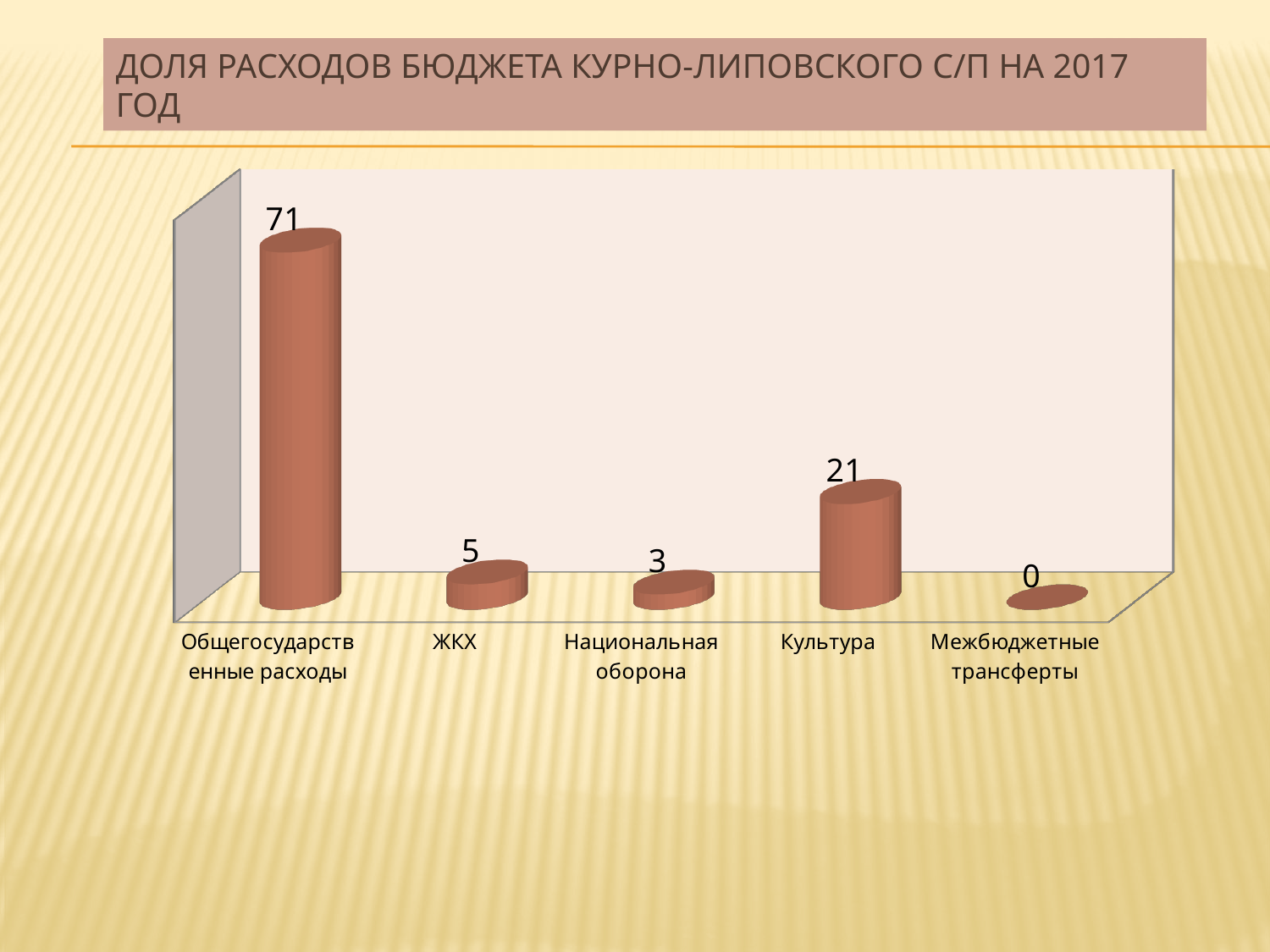
How many categories are shown in the chart? 5 Which category has the lowest value? Межбюджетные трансферты Which is larger, the value for ЖКХ or the value for Национальная оборона? ЖКХ What is the value for Общегосударственные расходы? 71 What is the value for Межбюджетные трансферты? 0 What is the value for ЖКХ? 5 What is the difference between the values for Общегосударственные расходы and Культура? 50 What kind of chart is shown on the slide? Bar chart What is the value for Национальная оборона? 3 Which category has the highest value? Общегосударственные расходы What is the value for Культура? 21 What is the title of the slide? Доля расходов бюджета Курно-Липовского с/п на 2017 год